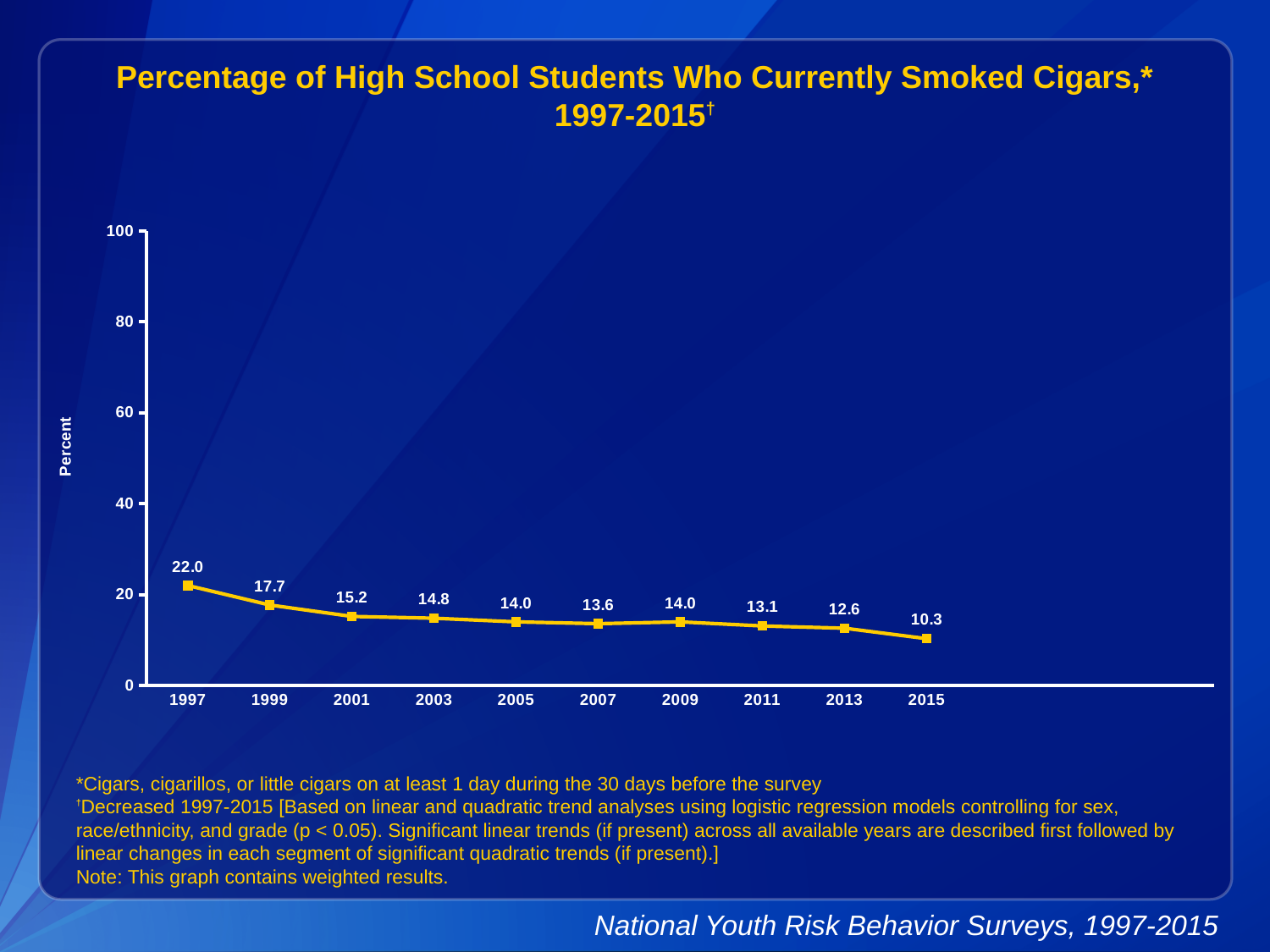
What is the difference between the values for 1999 and 2001? 2.5 What kind of chart is shown on the slide? Line chart Which year has the highest percentage of students who currently smoked cigars? 1997 Which year has the lowest percentage of students who currently smoked cigars? 2015 Is the value for 1997 greater or less than 20? greater Which year has a higher value, 2003 or 2013? 2003 What was the percentage of high school students who currently smoked cigars in 2015? 10.3 Do the values generally rise or fall from 1997 to 2015? Fall How many years are plotted on the chart? 10 By how many percentage points did the value change from 1997 to 2015? 11.7 What was the percentage of high school students who currently smoked cigars in 1997? 22.0 What value is shown for 2007? 13.6